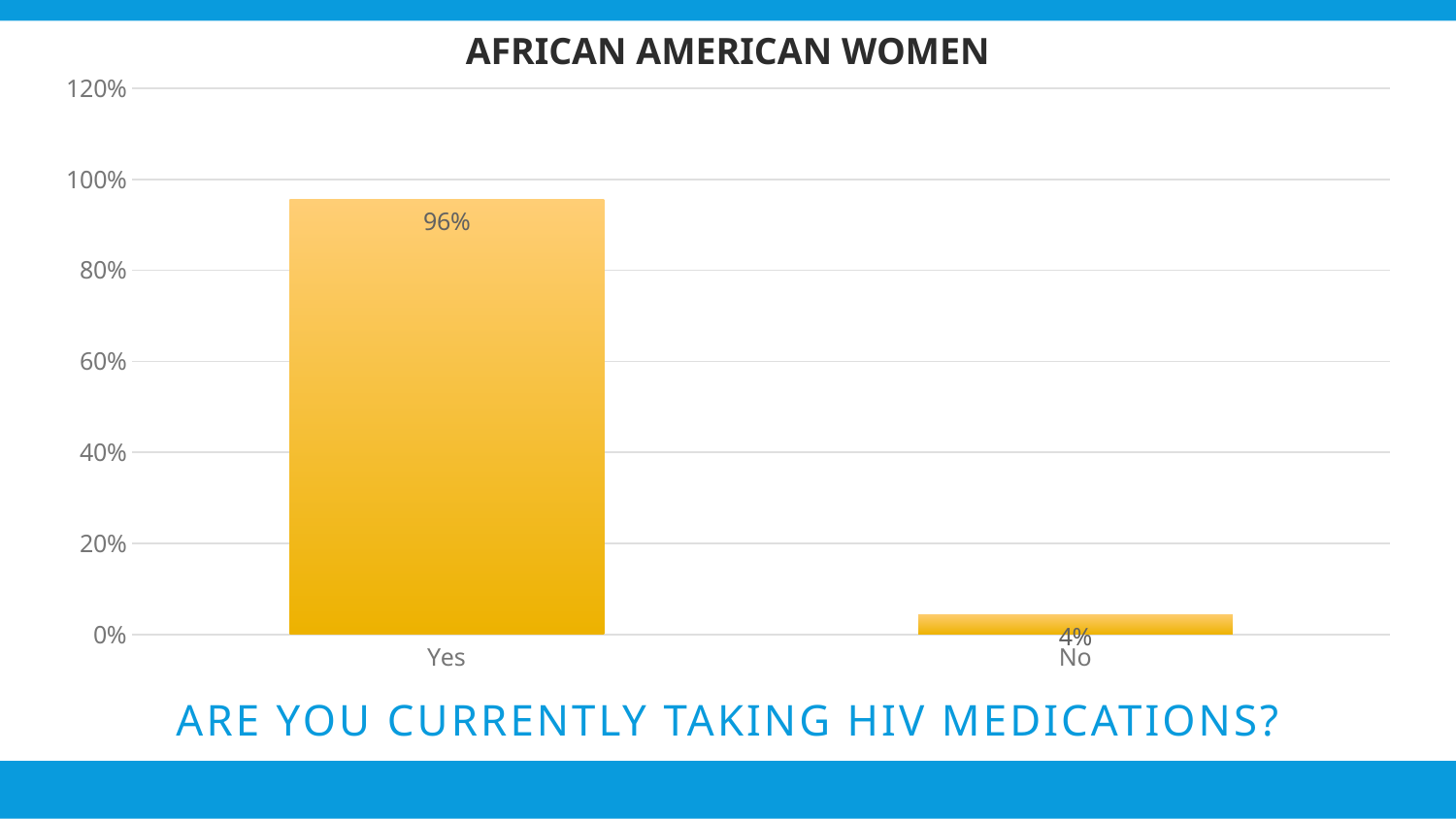
What is the value for No? 4% Is the value for Yes greater or less than 80%? greater What is the difference between the values for Yes and No? 92% Which is larger, the value for Yes or the value for No? Yes Which category has the highest value? Yes What is the highest value shown on the y axis? 120% What is the value for Yes? 96% What is the title of the chart? AFRICAN AMERICAN WOMEN Which category has the lowest value? No What kind of chart is shown on the slide? bar chart How many categories are shown on the x axis? 2 Is the value for No greater or less than 20%? less